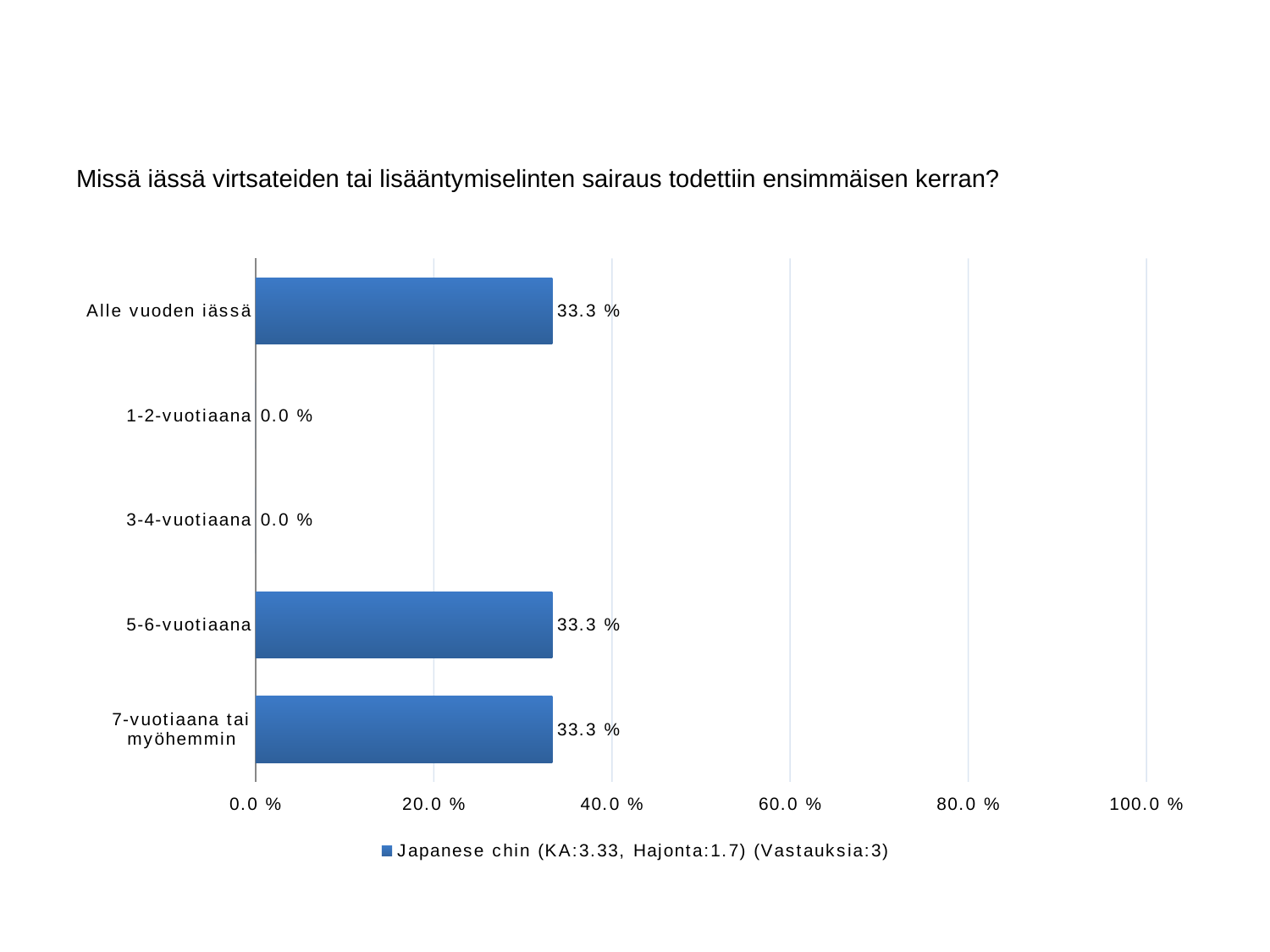
How many categories are shown on the chart? 5 Is the value for "7-vuotiaana tai myöhemmin" greater or less than 40.0 %? less What is the value for "3-4-vuotiaana"? 0.0 % What is the value for "1-2-vuotiaana"? 0.0 % What is the difference between the values for "Alle vuoden iässä" and "1-2-vuotiaana"? 33.3 % What is the value for "7-vuotiaana tai myöhemmin"? 33.3 % What is the series name shown in the legend? Japanese chin (KA:3.33, Hajonta:1.7) (Vastauksia:3) What is the value for "Alle vuoden iässä"? 33.3 % What kind of chart is shown on the slide? bar chart What is the value for "5-6-vuotiaana"? 33.3 % How many series does the legend list? 1 Which is larger, the value for "5-6-vuotiaana" or the value for "3-4-vuotiaana"? 5-6-vuotiaana